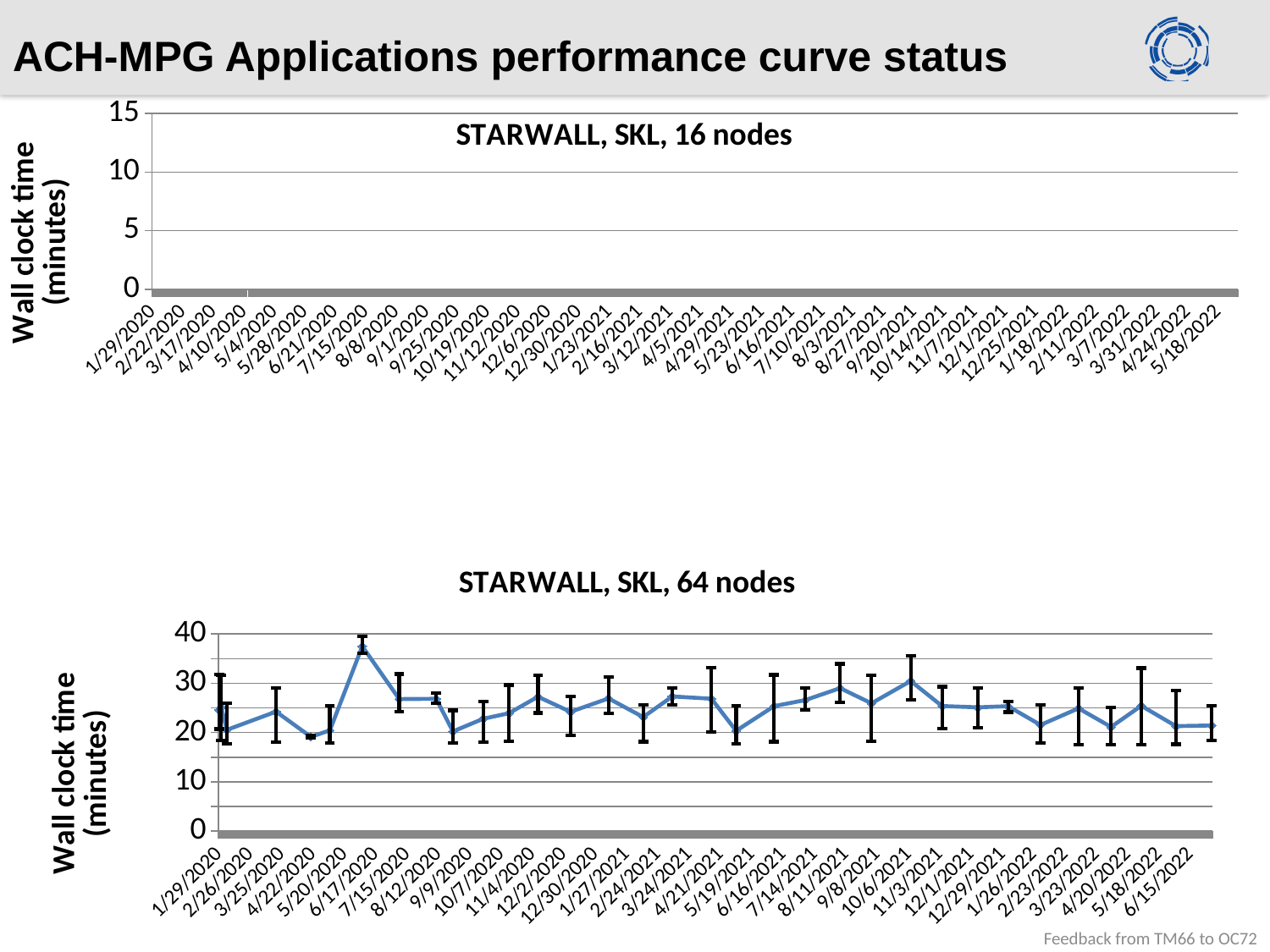
In the 'STARWALL, SKL, 64 nodes' chart, does the value rise or fall from 6/17/2020 to 7/15/2020? fall How many dates are shown on the x axis of the 'STARWALL, SKL, 64 nodes' chart? 32 What is the y-axis label of the bottom chart on the slide? Wall clock time (minutes) What kind of chart is the 'STARWALL, SKL, 64 nodes' chart? line chart In the 'STARWALL, SKL, 64 nodes' chart, is the value for 6/17/2020 greater or less than 30? greater What is the title of the top chart on the slide? STARWALL, SKL, 16 nodes In the 'STARWALL, SKL, 64 nodes' chart, does the value rise or fall from 5/20/2020 to 6/17/2020? rise In the 'STARWALL, SKL, 64 nodes' chart, is the value for 2/26/2020 greater or less than 30? less In the 'STARWALL, SKL, 64 nodes' chart, which is larger, the value for 10/6/2021 or the value for 5/19/2021? 10/6/2021 In the 'STARWALL, SKL, 64 nodes' chart, which is larger, the value for 6/17/2020 or the value for 4/22/2020? 6/17/2020 In the 'STARWALL, SKL, 64 nodes' chart, is the value for 8/11/2021 greater or less than 20? greater